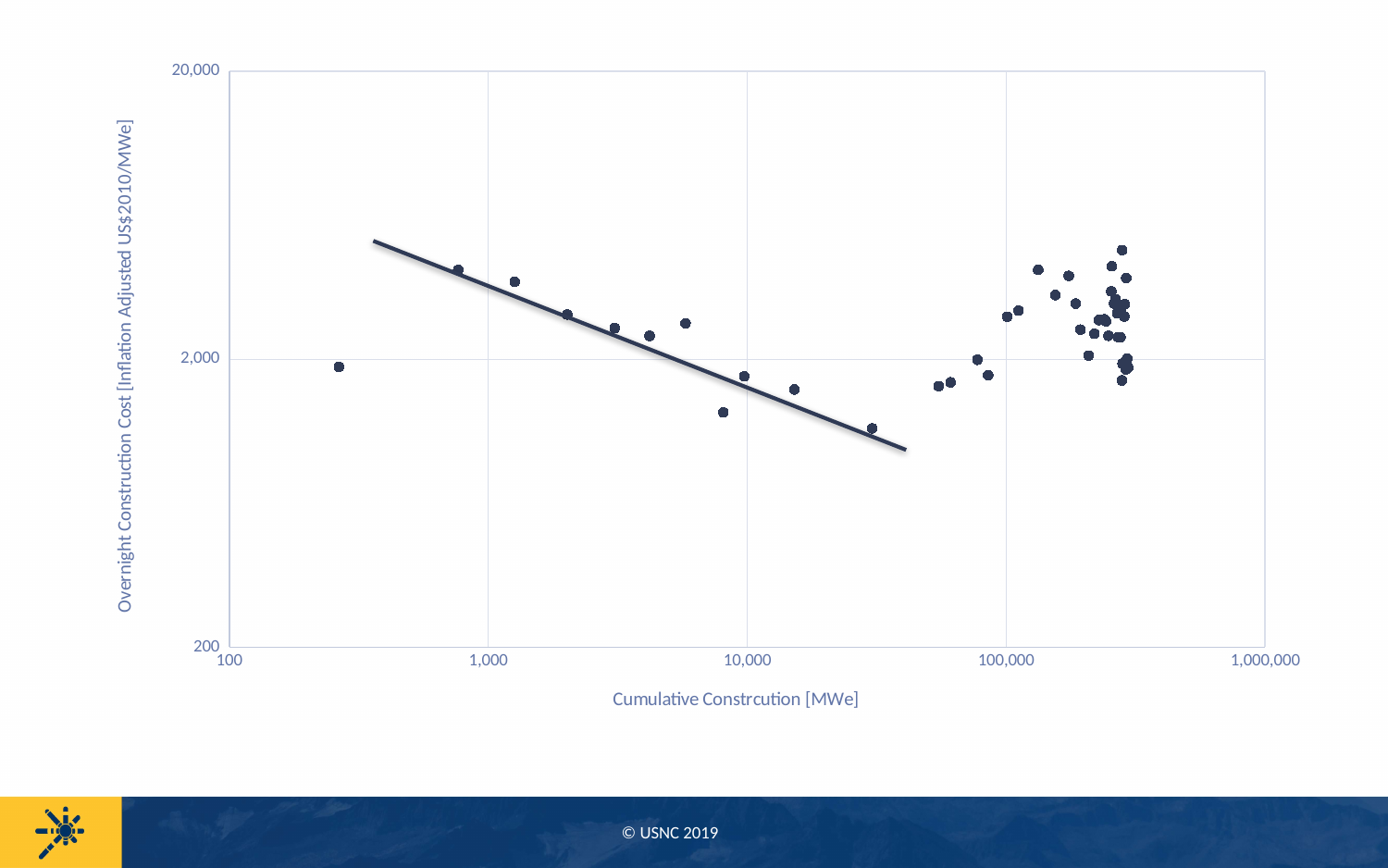
Is the overnight construction cost of the lowest plotted point greater or less than 200? greater Which has the higher overnight construction cost: the leftmost plotted point or the lowest plotted point? The leftmost plotted point Is the overnight construction cost of the lowest plotted point greater or less than 2,000? less Is the overnight construction cost of the point plotted near 30,000 MWe greater or less than 2,000? less What is the label of the x axis? Cumulative Constrcution [MWe] Along the fitted trend line, does overnight construction cost rise or fall as cumulative construction increases? Fall What is the label of the y axis? Overnight Construction Cost [Inflation Adjusted US$2010/MWe] What kind of chart is shown on the slide? Scatter chart